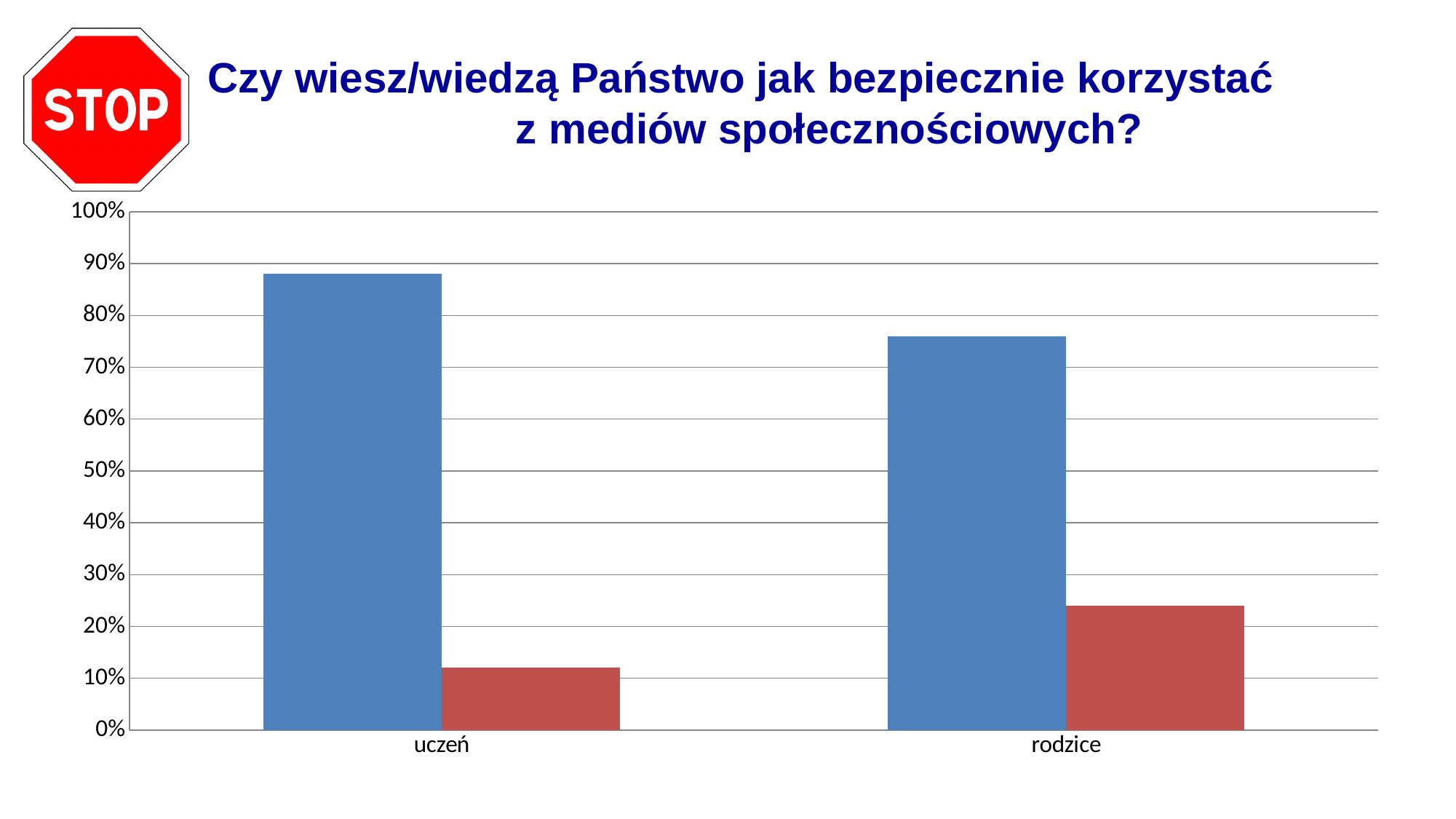
How many categories are shown on the x axis of the chart? 2 Is the red bar for rodzice greater or less than 30%? less Is the red bar for uczeń greater or less than 20%? less Is the blue bar for rodzice greater or less than 70%? greater Which category has the taller red bar, uczeń or rodzice? rodzice Which bar in the chart is the tallest? the blue bar for uczeń What kind of chart is shown on the slide? bar chart Which category has the taller blue bar, uczeń or rodzice? uczeń What are the two categories on the x axis of the chart? uczeń, rodzice Which bar in the chart is the shortest? the red bar for uczeń What is the highest value shown on the y axis of the chart? 100%